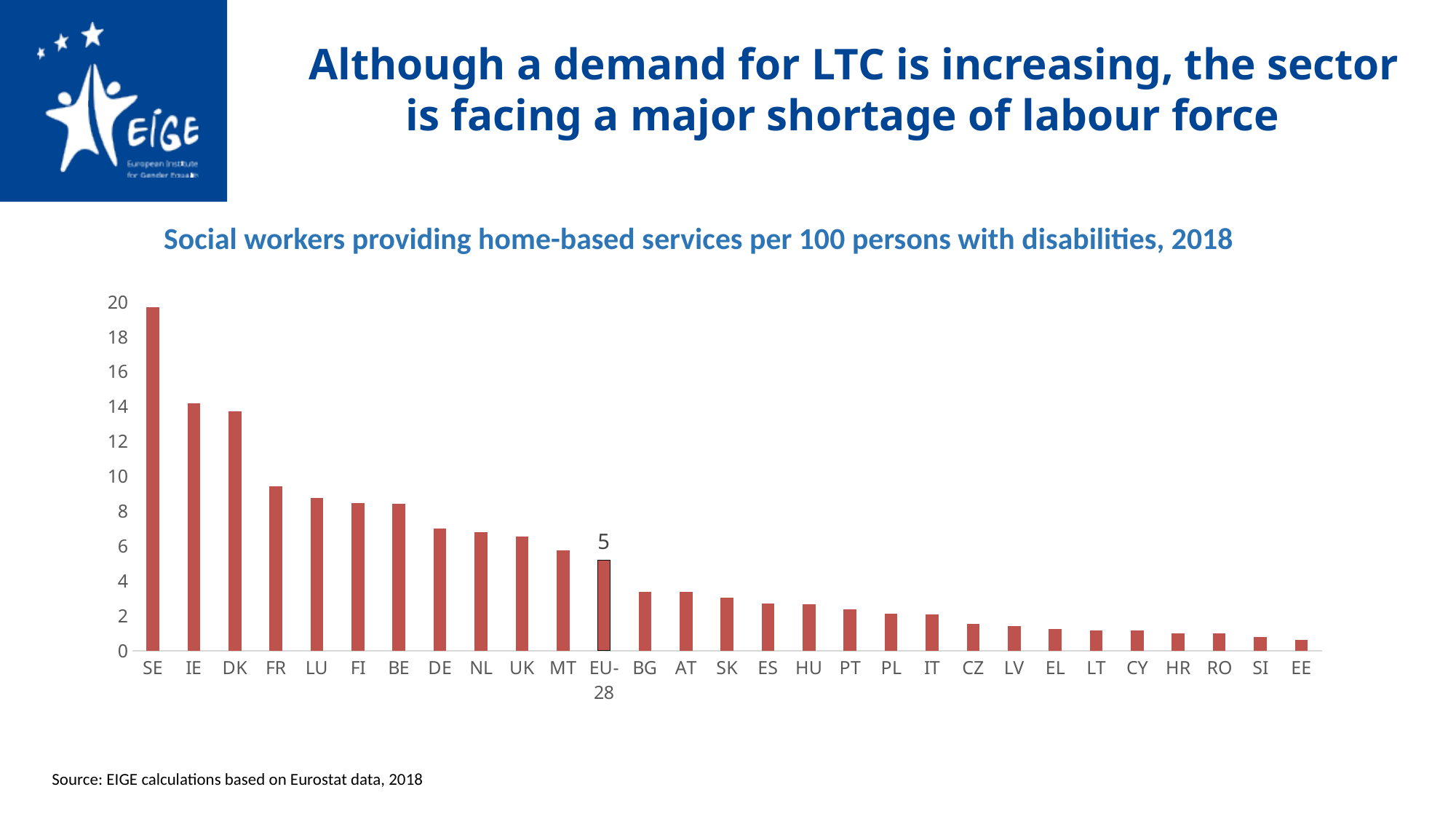
Which country has the highest number of social workers providing home-based services per 100 persons with disabilities? SE Is the value for BG greater or less than 4? less Do the values rise or fall moving from left to right along the x axis? fall Which country has the lowest value in the chart? EE What kind of chart is shown on the slide? bar chart What is the title of the chart? Social workers providing home-based services per 100 persons with disabilities, 2018 How many categories (bars) are shown on the x axis? 29 What is the value shown for EU-28? 5 Is the value for IE greater or less than 12? greater Is the value for FR greater or less than 10? less Which has a larger value, DK or FR? DK